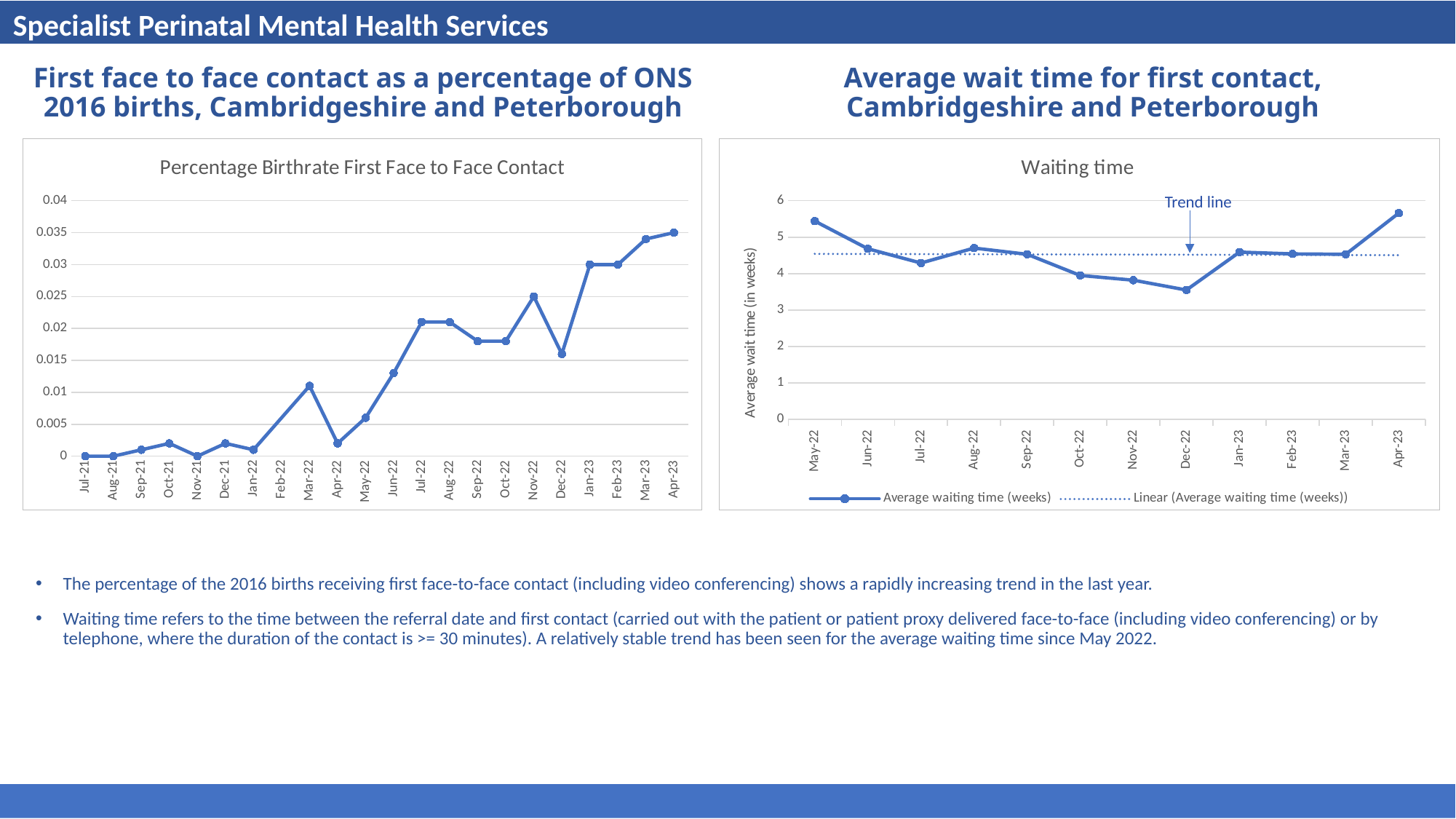
In the 'Waiting time' chart, is the value for May-22 greater or less than 5? greater What is the y-axis label of the 'Waiting time' chart? Average wait time (in weeks) In the 'Percentage Birthrate First Face to Face Contact' chart, which month has the highest value? Apr-23 What kind of chart is the 'Waiting time' chart on the right? Line chart In the 'Waiting time' chart, which month has the lowest average waiting time? Dec-22 In the 'Waiting time' chart, is the value for Dec-22 greater or less than 4? less How many months are plotted on the x axis of the 'Waiting time' chart? 12 In the 'Waiting time' chart, which month has the highest average waiting time? Apr-23 In the 'Waiting time' chart, which is larger: the value for Jun-22 or the value for Nov-22? Jun-22 How many entries does the legend of the 'Waiting time' chart list? 2 In the 'Percentage Birthrate First Face to Face Contact' chart, do the values generally rise or fall from Jul-21 to Apr-23? Rise